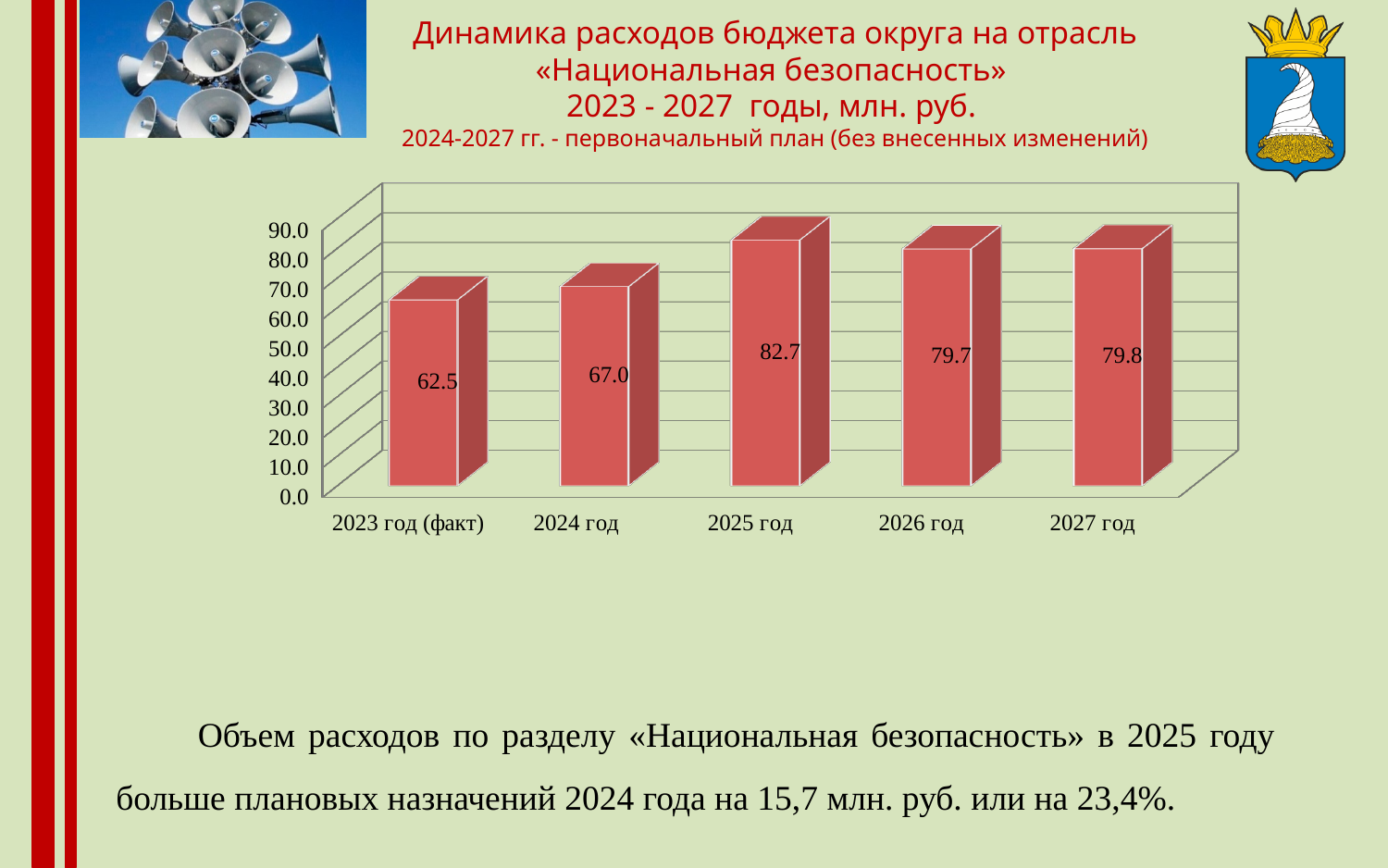
Do the values rise or fall from 2023 год (факт) to 2025 год? rise What kind of chart is shown on the slide? bar chart Which year has the lowest value? 2023 год (факт) What is the value for 2023 год (факт)? 62.5 What is the value for 2027 год? 79.8 Is the value for 2025 год greater or less than 80.0? greater What is the difference between the values for 2027 год and 2026 год? 0.1 Which is larger, the value for 2024 год or the value for 2026 год? 2026 год Which year has the highest value? 2025 год What is the difference between the values for 2025 год and 2024 год? 15.7 How many years are shown on the x axis? 5 What is the value for 2025 год? 82.7